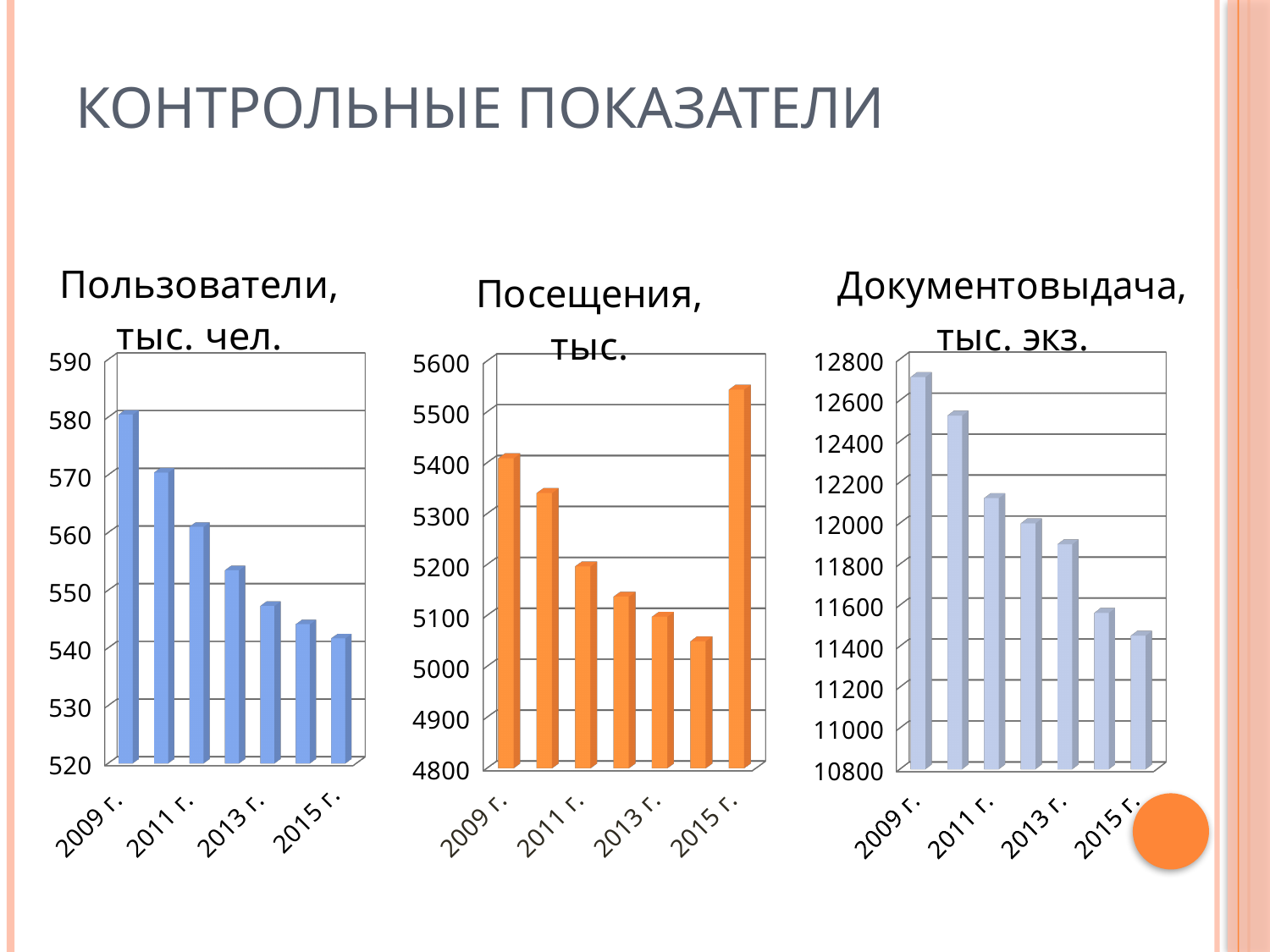
How many bars does the "Посещения, тыс." chart have? 7 What kind of chart is the "Пользователи, тыс. чел." chart? bar chart In the "Пользователи, тыс. чел." chart, is the value for 2013 г. greater or less than 550? less In the "Документовыдача, тыс. экз." chart, is the value for 2009 г. greater or less than 12600? greater In the "Документовыдача, тыс. экз." chart, do the values rise or fall from 2009 to 2015? fall In the "Пользователи, тыс. чел." chart, which year has the lowest value? 2015 г. In the "Посещения, тыс." chart, which is larger, the value for 2009 г. or the value for 2013 г.? 2009 г. In the "Пользователи, тыс. чел." chart, which year has the highest value? 2009 г. In the "Посещения, тыс." chart, which year has the highest value? 2015 г. In the "Посещения, тыс." chart, is the value for 2015 г. greater or less than 5500? greater What is the title of the slide? КОНТРОЛЬНЫЕ ПОКАЗАТЕЛИ In the "Документовыдача, тыс. экз." chart, which year has the lowest value? 2015 г.